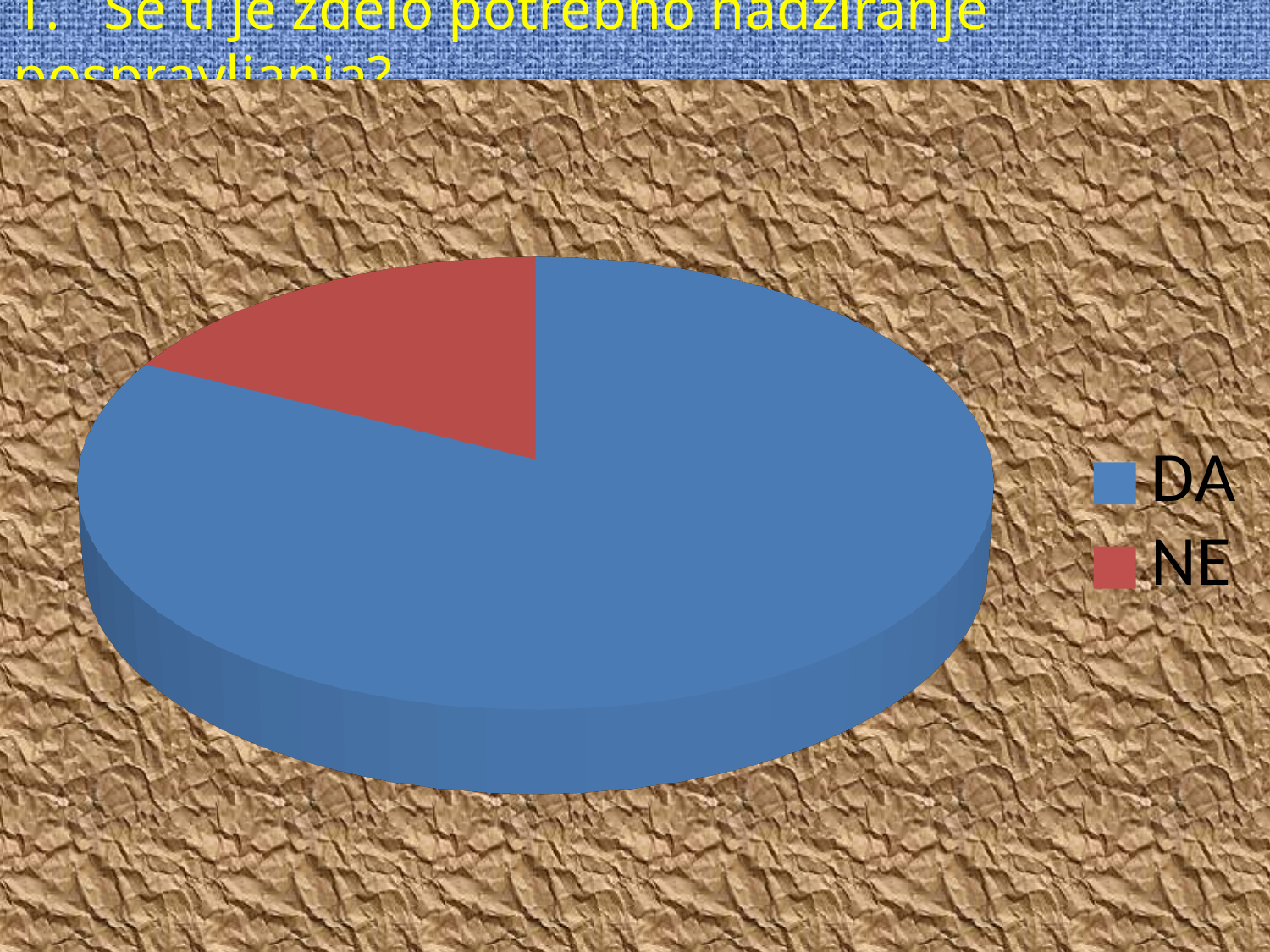
Which category has the largest slice of the pie? DA How many entries does the legend list? 2 How many slices does the pie chart have? 2 What colour is the NE slice in the pie chart? red What colour is the DA slice in the pie chart? blue Which slice is larger, DA or NE? DA What kind of chart is shown on the slide? pie chart Which category has the smallest slice of the pie? NE